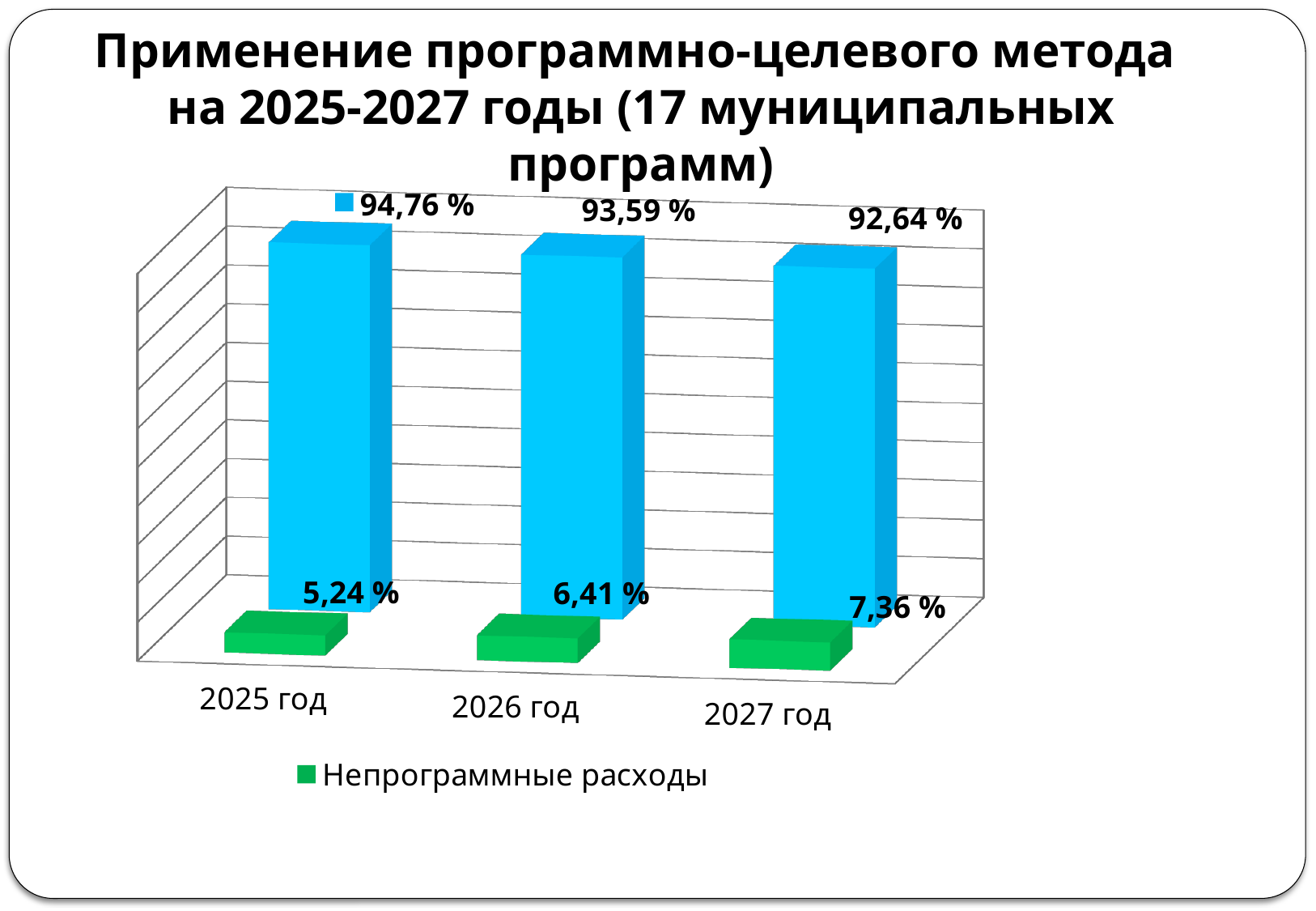
Which year has the larger blue bar value, 2025 год or 2026 год? 2025 год What kind of chart is shown on the slide? bar chart What is the value of Непрограммные расходы for 2027 год? 7,36 % How many years are shown on the x axis of the chart? 3 Do the values of Непрограммные расходы rise or fall from 2025 год to 2027 год? rise In which year is the blue bar the lowest? 2027 год What is the value of Непрограммные расходы for 2026 год? 6,41 % What is the difference between Непрограммные расходы in 2027 год and in 2025 год? 2,12 % What value is shown on the tall blue bar for 2025 год? 94,76 % What is the value of Непрограммные расходы for 2025 год? 5,24 % In which year is the value of Непрограммные расходы the highest? 2027 год What value is shown on the tall blue bar for 2027 год? 92,64 %